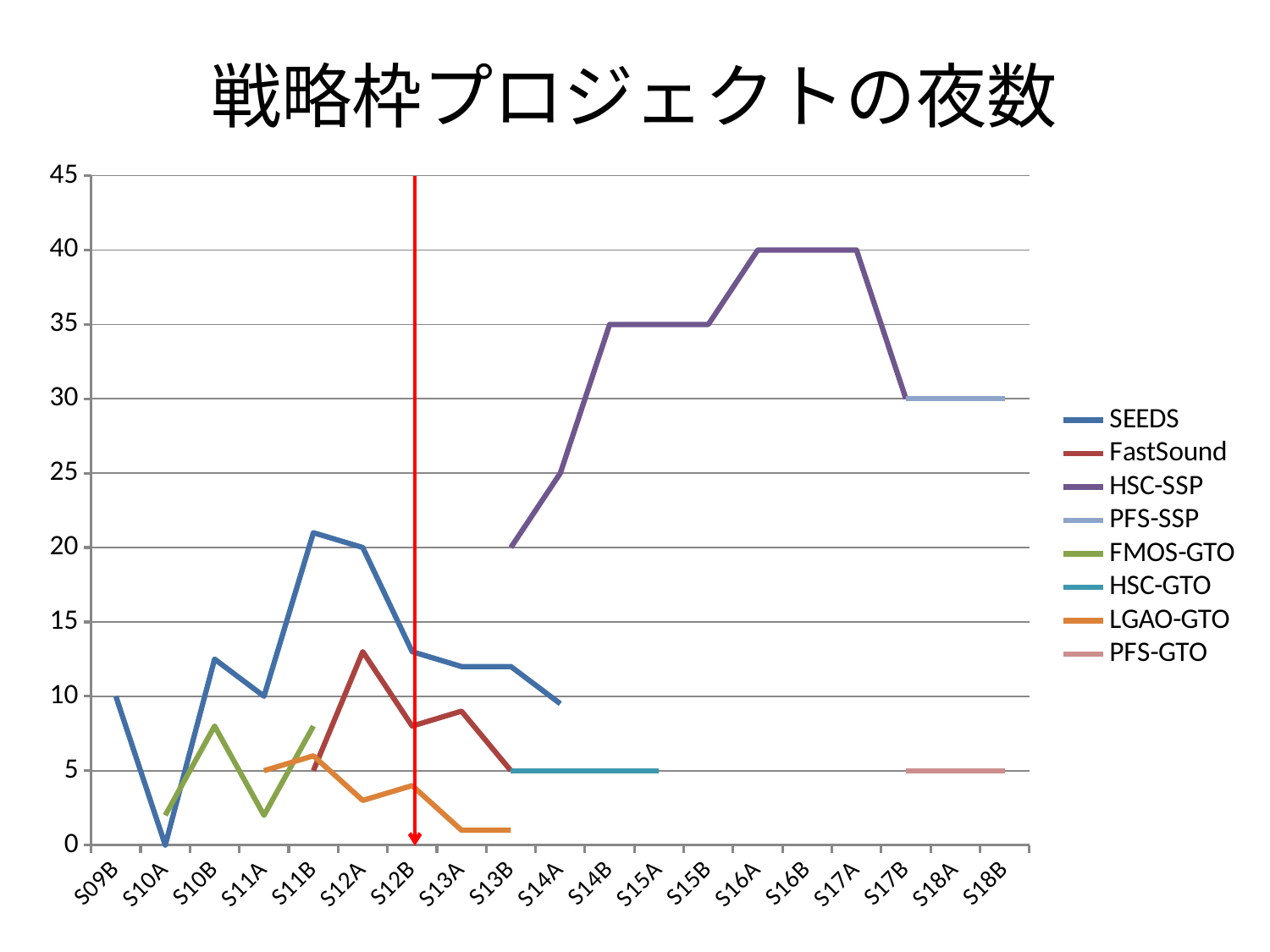
How many series does the legend list? 8 Which is larger at S12A, SEEDS or FastSound? SEEDS What is the value for HSC-SSP at S16A? 40 What is the value for HSC-GTO at S14B? 5 What is the value for SEEDS at S10A? 0 What is the value for PFS-SSP at S18B? 30 What is the value for HSC-SSP at S14B? 35 Is the value for FastSound at S12A greater or less than 10? greater What kind of chart is shown on the slide? line chart How many categories are shown on the x axis? 19 Is the value for SEEDS at S11B greater or less than 20? greater Which series reaches the highest value on the chart? HSC-SSP